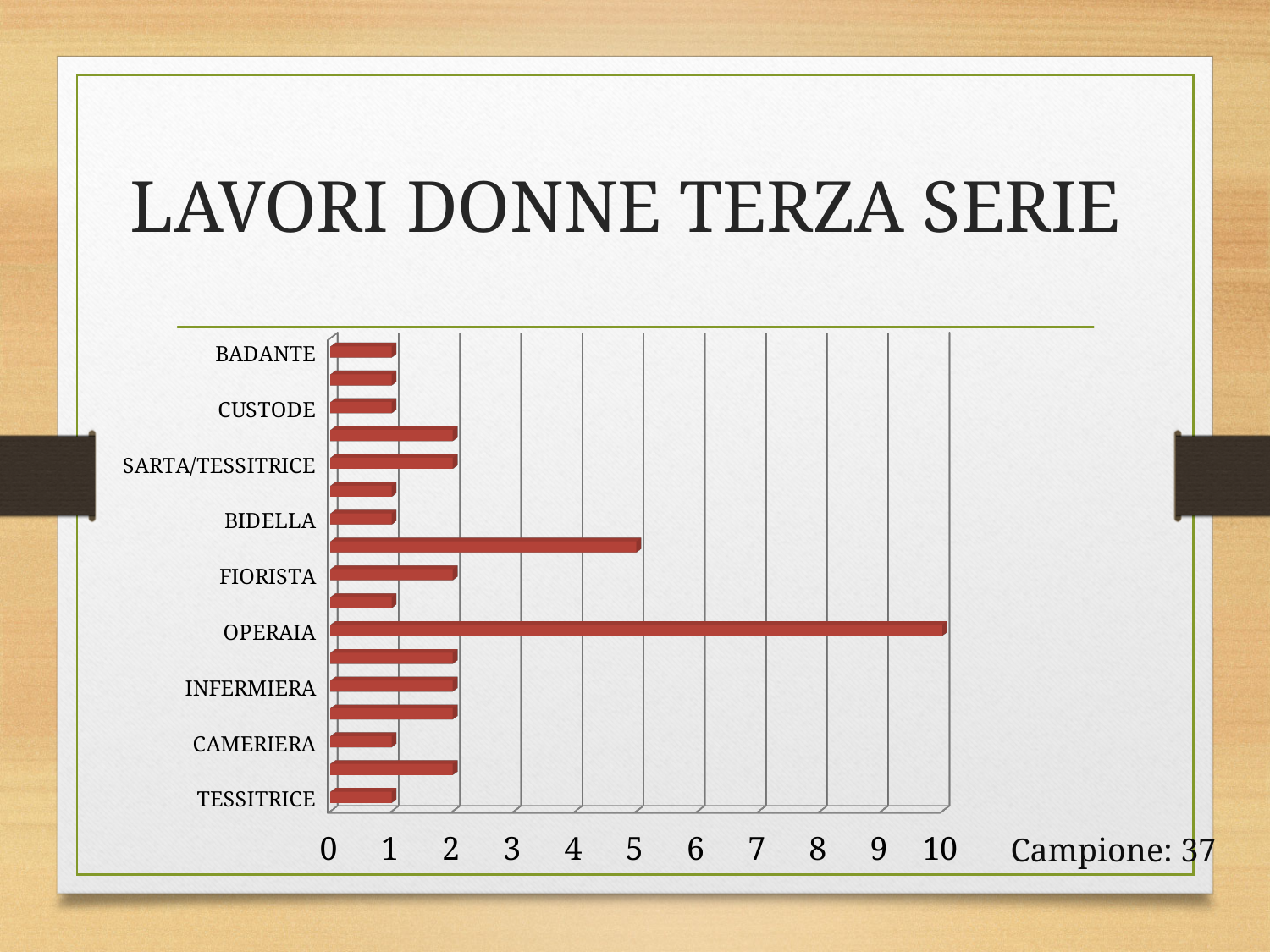
What is the difference between the values for OPERAIA and FIORISTA? 8 What is the value for OPERAIA? 10 Which category has the highest value? OPERAIA Which is larger, the value for OPERAIA or the value for SARTA/TESSITRICE? OPERAIA What is the value for SARTA/TESSITRICE? 2 Is the value for OPERAIA greater or less than 5? greater What is the title of the slide? LAVORI DONNE TERZA SERIE What is the value for BADANTE? 1 What is the highest value shown on the horizontal axis? 10 What kind of chart is shown on the slide? bar chart What is the value for CAMERIERA? 1 What is the value for INFERMIERA? 2